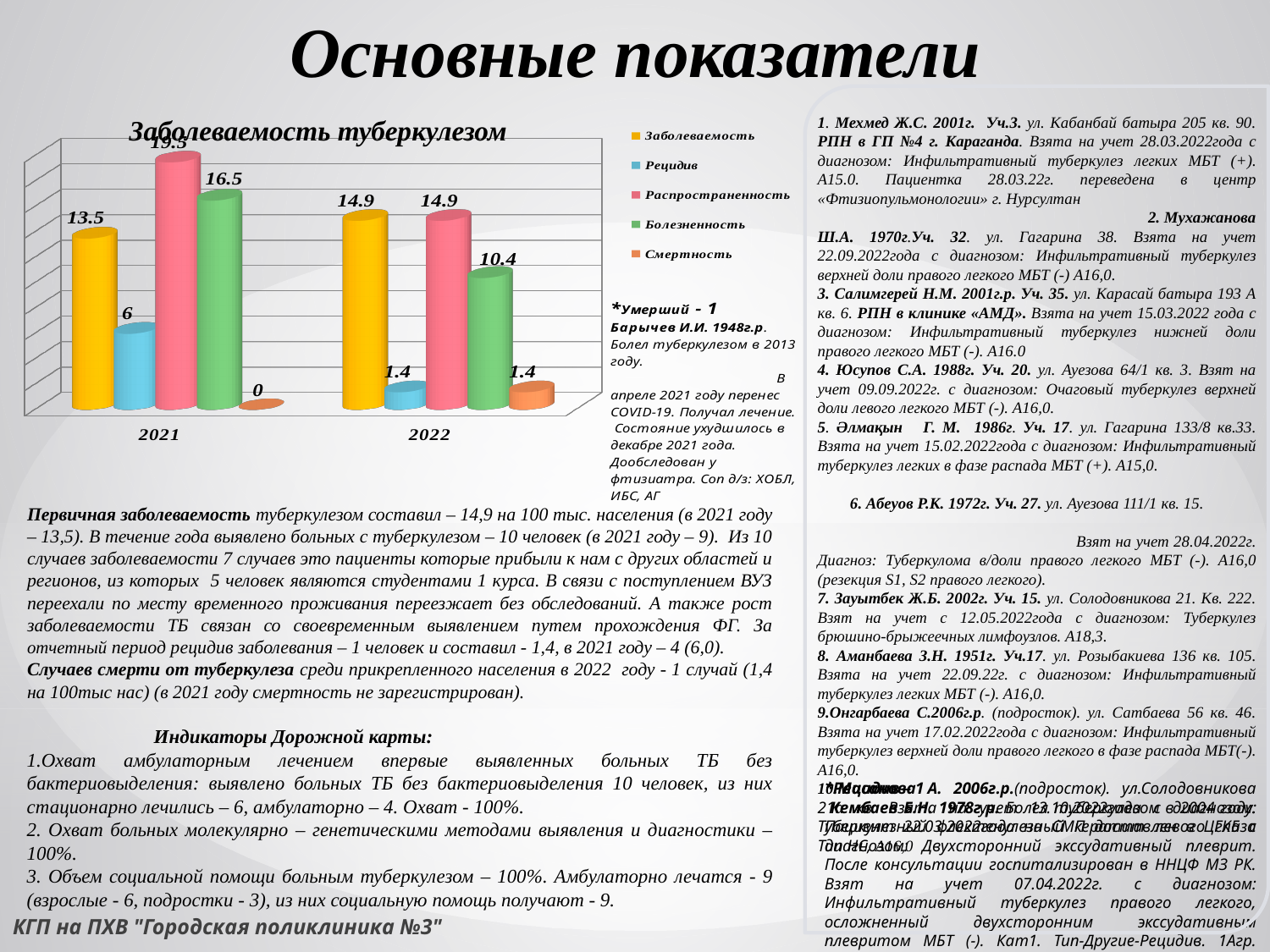
What is the difference between Распространенность in 2021 and in 2022? 4.6 What kind of chart is shown? Bar chart Which series has the highest value in 2021? Распространенность How many series does the legend list? 5 What is the value of Распространенность for 2021? 19.5 What is the value of Рецидив for 2022? 1.4 Which is larger: Рецидив in 2021 or Рецидив in 2022? Рецидив in 2021 What is the value of Заболеваемость for 2021? 13.5 What is the title of the chart? Заболеваемость туберкулезом Which series has the lowest value in 2021? Смертность What is the value of Смертность for 2021? 0 What is the value of Болезненность for 2022? 10.4